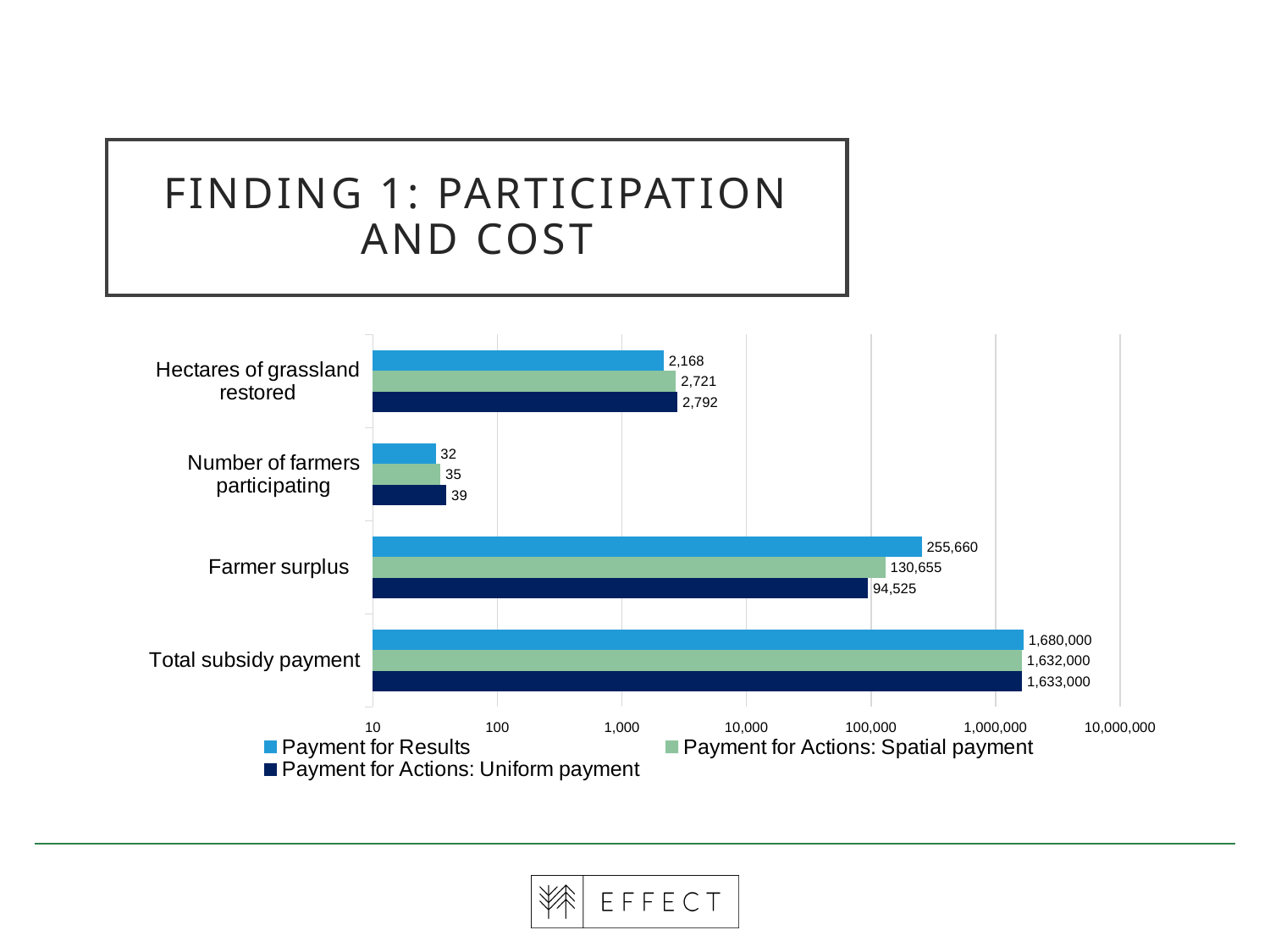
What kind of chart is shown on the slide? Bar chart What is the Total subsidy payment under Payment for Actions: Uniform payment? 1,633,000 What is the difference in Hectares of grassland restored between Payment for Actions: Uniform payment and Payment for Actions: Spatial payment? 71 Which payment scheme has the highest Farmer surplus? Payment for Results What is the Farmer surplus under Payment for Actions: Spatial payment? 130,655 Which payment scheme has the lowest Number of farmers participating? Payment for Results Which is larger: Total subsidy payment under Payment for Results or under Payment for Actions: Spatial payment? Payment for Results What is the value for Hectares of grassland restored under Payment for Results? 2,168 How many series does the legend list? 3 How many categories are shown on the y axis of the chart? 4 How many farmers participate under Payment for Actions: Uniform payment? 39 What is the difference in Farmer surplus between Payment for Results and Payment for Actions: Uniform payment? 161,135